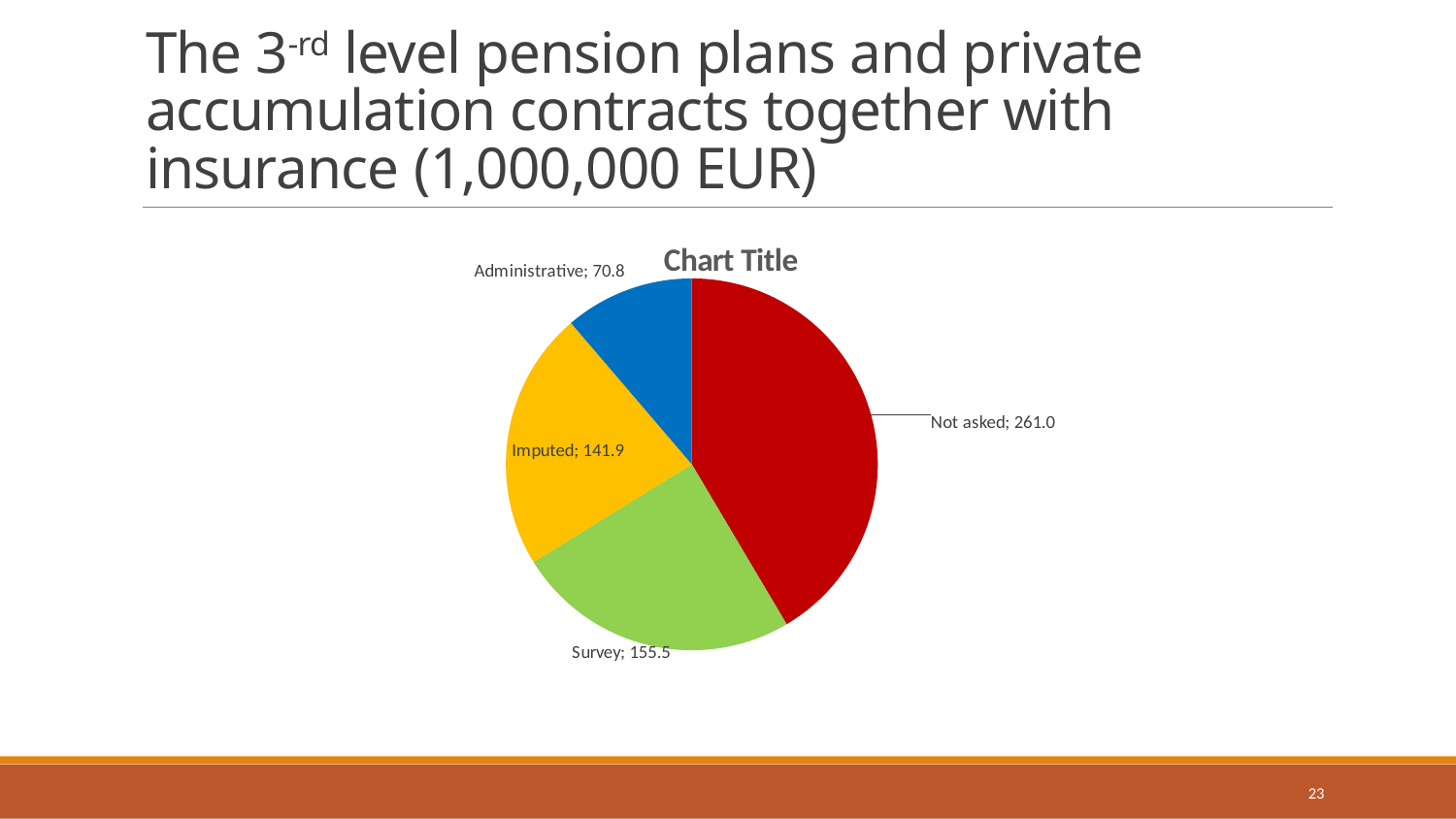
Which category has the smallest slice of the pie? Administrative What colour is the Not asked slice? Red What kind of chart is shown on the slide? Pie chart Which is larger, the Survey value or the Imputed value? Survey What is the value of the Not asked slice? 261.0 What is the difference between the Not asked value and the Survey value? 105.5 What is the value of the Imputed slice? 141.9 What is the value of the Administrative slice? 70.8 What is the difference between the Imputed value and the Administrative value? 71.1 What is the value of the Survey slice? 155.5 How many slices does the pie chart have? 4 Which category has the largest slice of the pie? Not asked